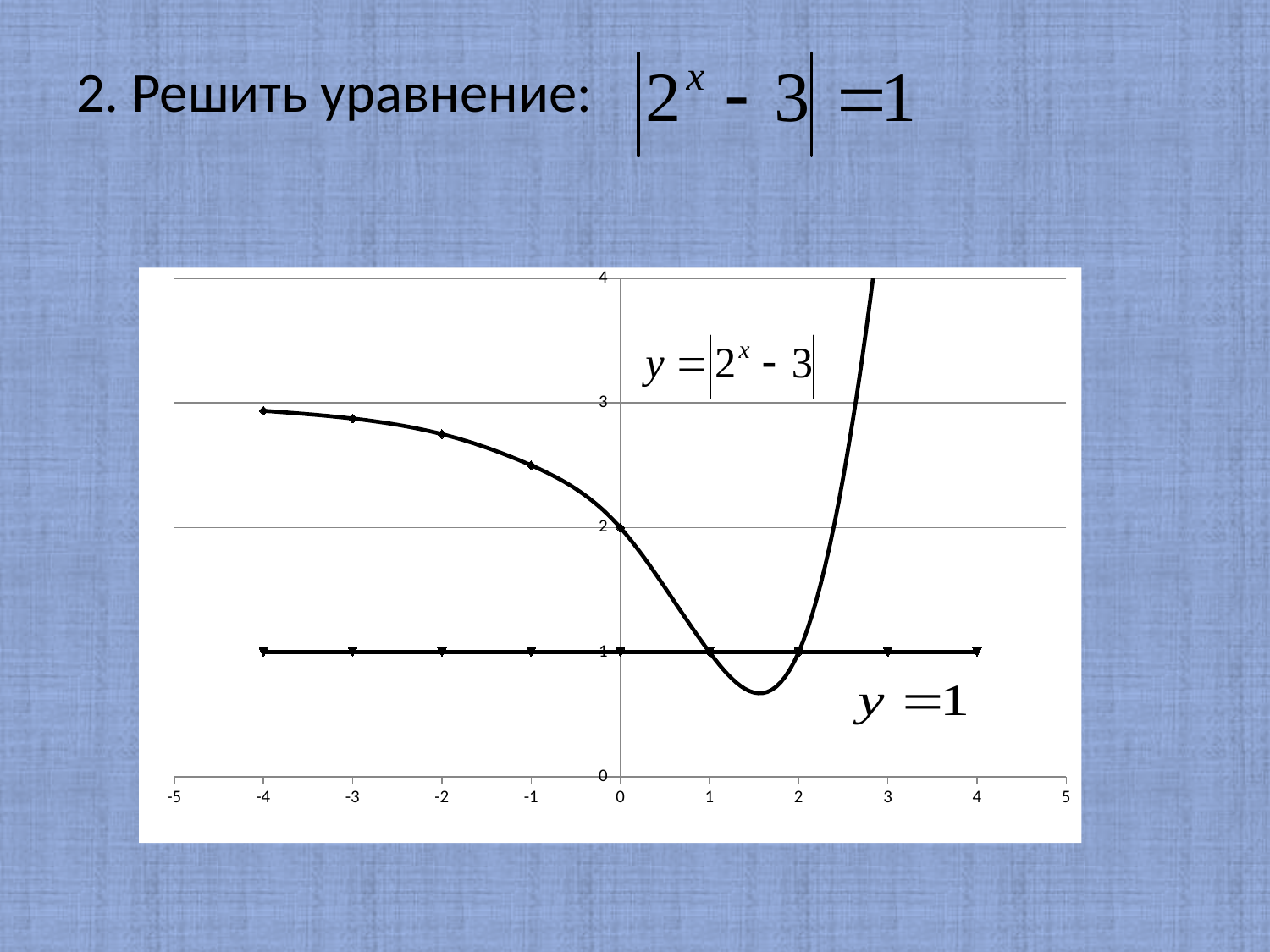
What kind of chart is shown on the slide? line chart How many marked points are on the line y = 1? 9 Does the curve y = |2^x - 3| rise or fall as x goes from -4 to 0? fall What is the value of the line y = 1 at x = 3? 1 Is the lowest point of the curve y = |2^x - 3| greater or less than 1? less What is the value of the curve y = |2^x - 3| at x = 1? 1 Is the value of the curve y = |2^x - 3| at x = -1 greater or less than 2? greater At x = -2, which is larger: the curve y = |2^x - 3| or the line y = 1? y = |2^x - 3| Is the value of the curve y = |2^x - 3| at x = -4 greater or less than 2? greater What is the value of the curve y = |2^x - 3| at x = 0? 2 How many curves (series) are plotted on the chart? 2 What is the value of the curve y = |2^x - 3| at x = 2? 1